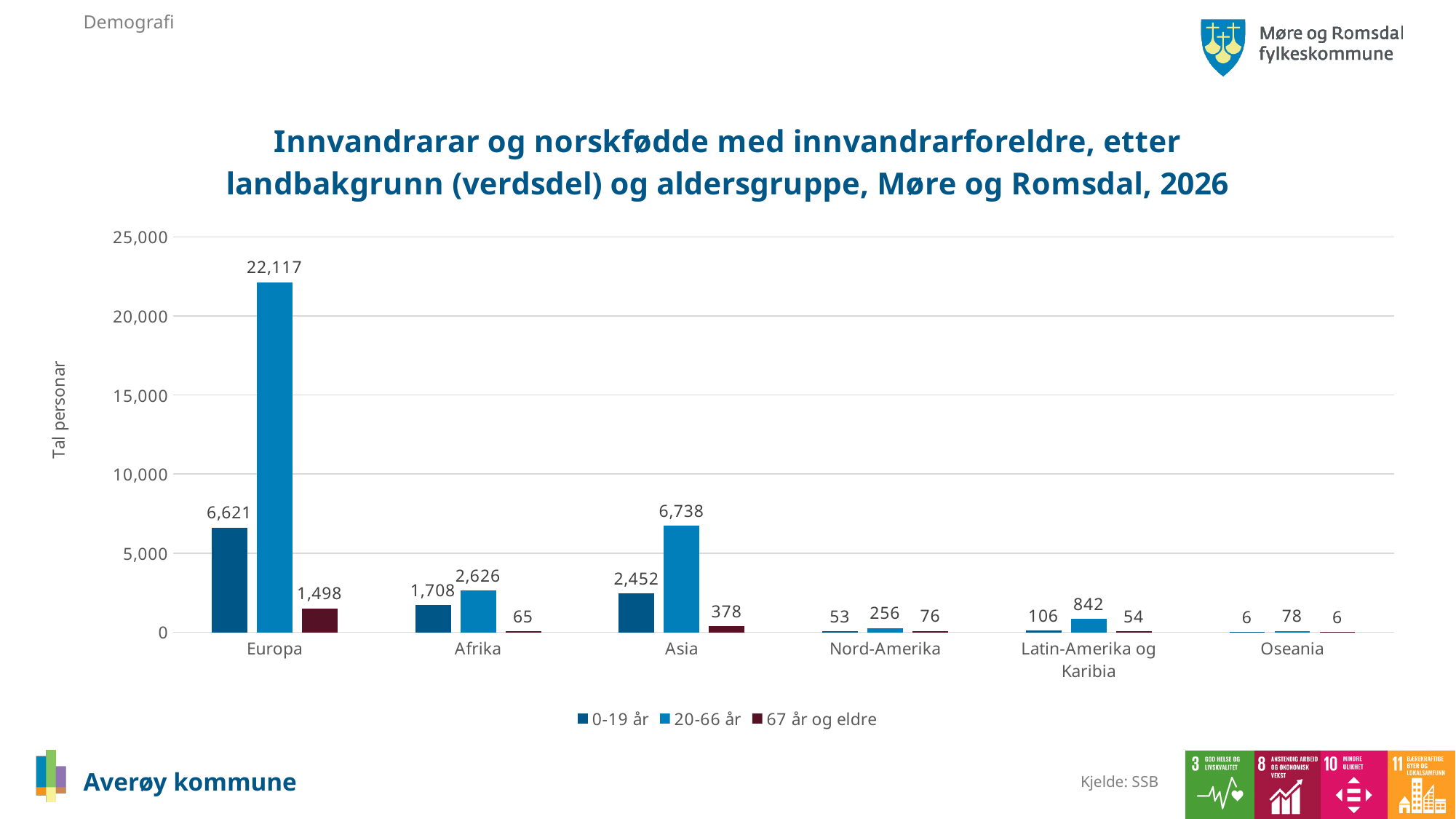
What is the value for the 67 år og eldre series for Asia? 378 Which category has the highest value in the 20-66 år series? Europa What is the label of the y axis? Tal personar What is the value for the 20-66 år series for Europa? 22,117 What kind of chart is shown on the slide? bar chart Which is larger: the 0-19 år value for Asia or the 0-19 år value for Afrika? Asia Is the value for the 20-66 år series for Europa greater or less than 20,000? greater How many series does the legend list? 3 What is the difference between the 20-66 år values for Asia and Afrika? 4,112 What is the value for the 0-19 år series for Latin-Amerika og Karibia? 106 How many categories are shown on the x axis? 6 Which category has the lowest value in the 0-19 år series? Oseania